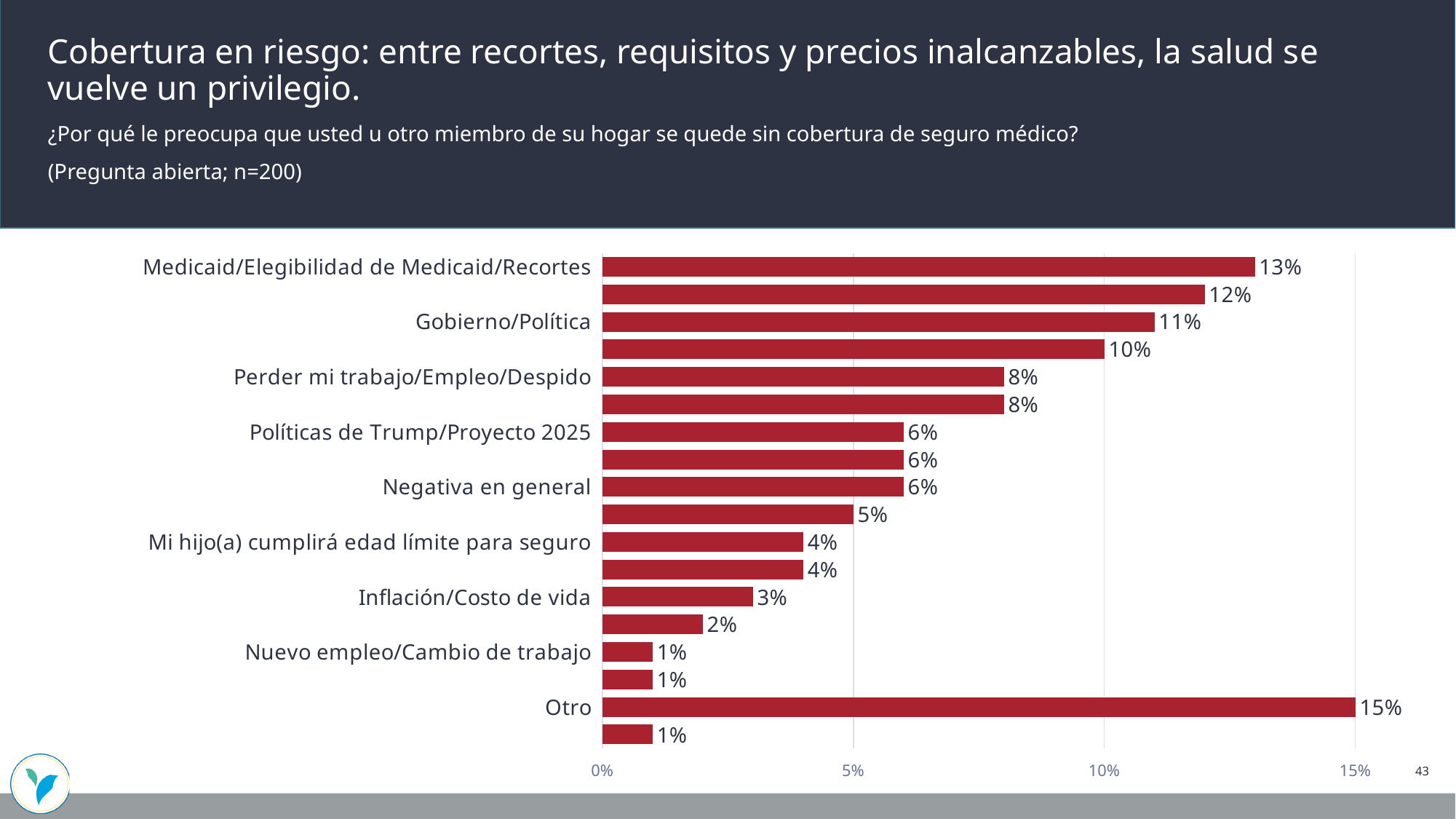
Which is larger, the value for Gobierno/Política or the value for Perder mi trabajo/Empleo/Despido? Gobierno/Política What value is shown for Otro? 15% What value is shown for Inflación/Costo de vida? 3% What value is shown for Gobierno/Política? 11% Which labeled category has the highest value? Otro What value is shown for Perder mi trabajo/Empleo/Despido? 8% What value is shown for Medicaid/Elegibilidad de Medicaid/Recortes? 13% What kind of chart is shown on the slide? bar chart What is the difference between the values for Otro and Medicaid/Elegibilidad de Medicaid/Recortes? 2% How many bars are plotted in the chart? 18 Is the value for Mi hijo(a) cumplirá edad límite para seguro greater or less than 5%? less What value is shown for Nuevo empleo/Cambio de trabajo? 1%